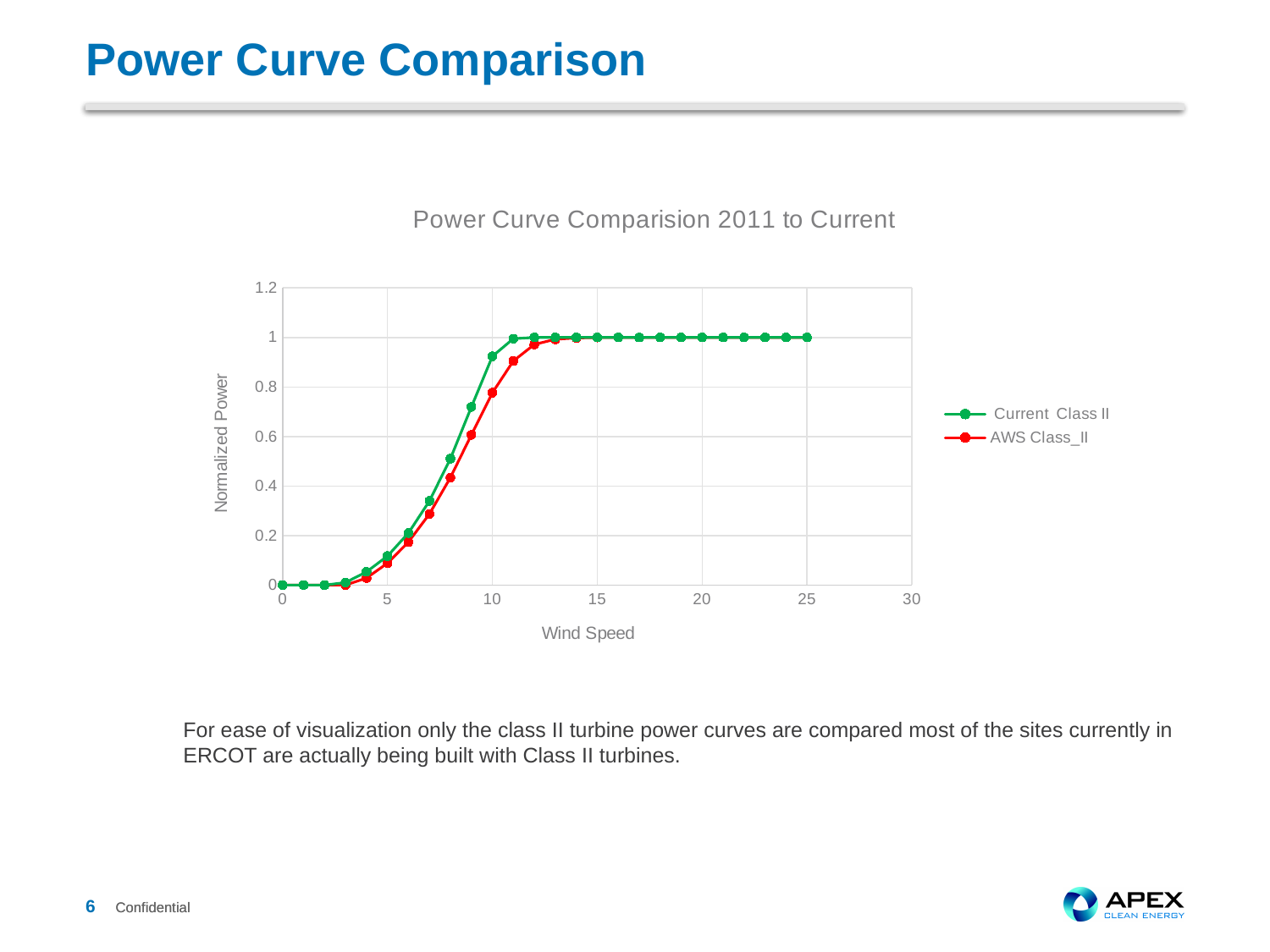
Is the value for AWS Class_II at a wind speed of 7 greater or less than 0.2? greater Do the values for Current Class II rise or fall as wind speed increases from 5 to 10? Rise At a wind speed of 9, which series has the larger value, Current Class II or AWS Class_II? Current Class II What kind of chart is shown on the slide? Line chart What is the value for AWS Class_II at a wind speed of 0? 0 Which series is drawn in red? AWS Class_II Is the value for Current Class II at a wind speed of 8 greater or less than 0.4? greater What is the title of the chart? Power Curve Comparision 2011 to Current How many series does the legend list? 2 What is the value for Current Class II at a wind speed of 20? 1 Is the value for AWS Class_II at a wind speed of 11 greater or less than 0.8? greater